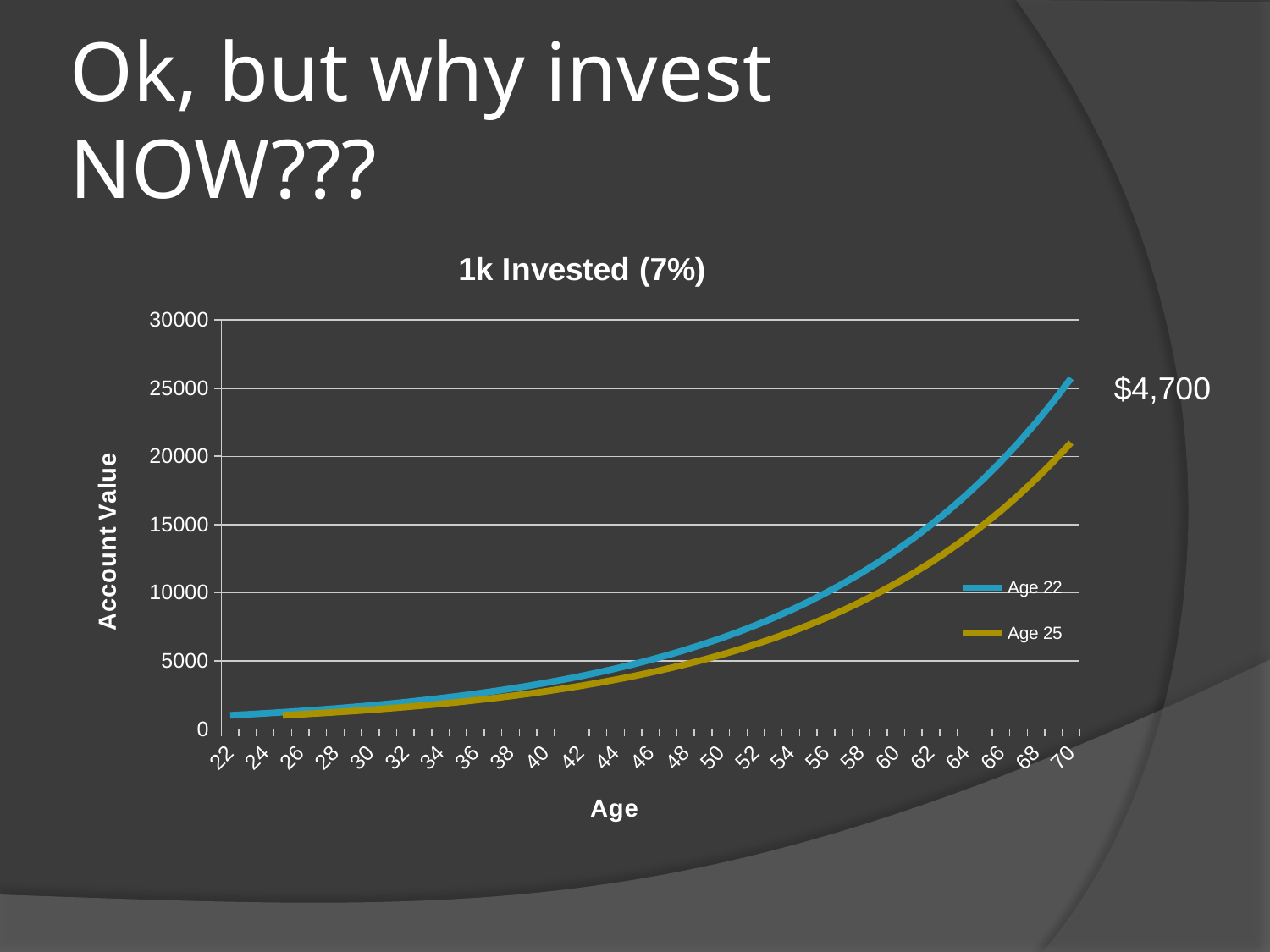
At age 70, which series has the higher account value, Age 22 or Age 25? Age 22 What kind of chart is shown on the slide? line chart Which series reaches the highest account value on the chart? Age 22 Is the value for the Age 22 series at age 60 greater or less than 10000? greater Is the value for the Age 22 series at age 50 greater or less than 10000? less How many series does the legend list? 2 What dollar amount is annotated to the right of the chart near the end of the lines? $4,700 Is the value for the Age 25 series at age 40 greater or less than 5000? less Do the account values rise or fall as age increases along the x axis? rise What is the title of the chart? 1k Invested (7%)